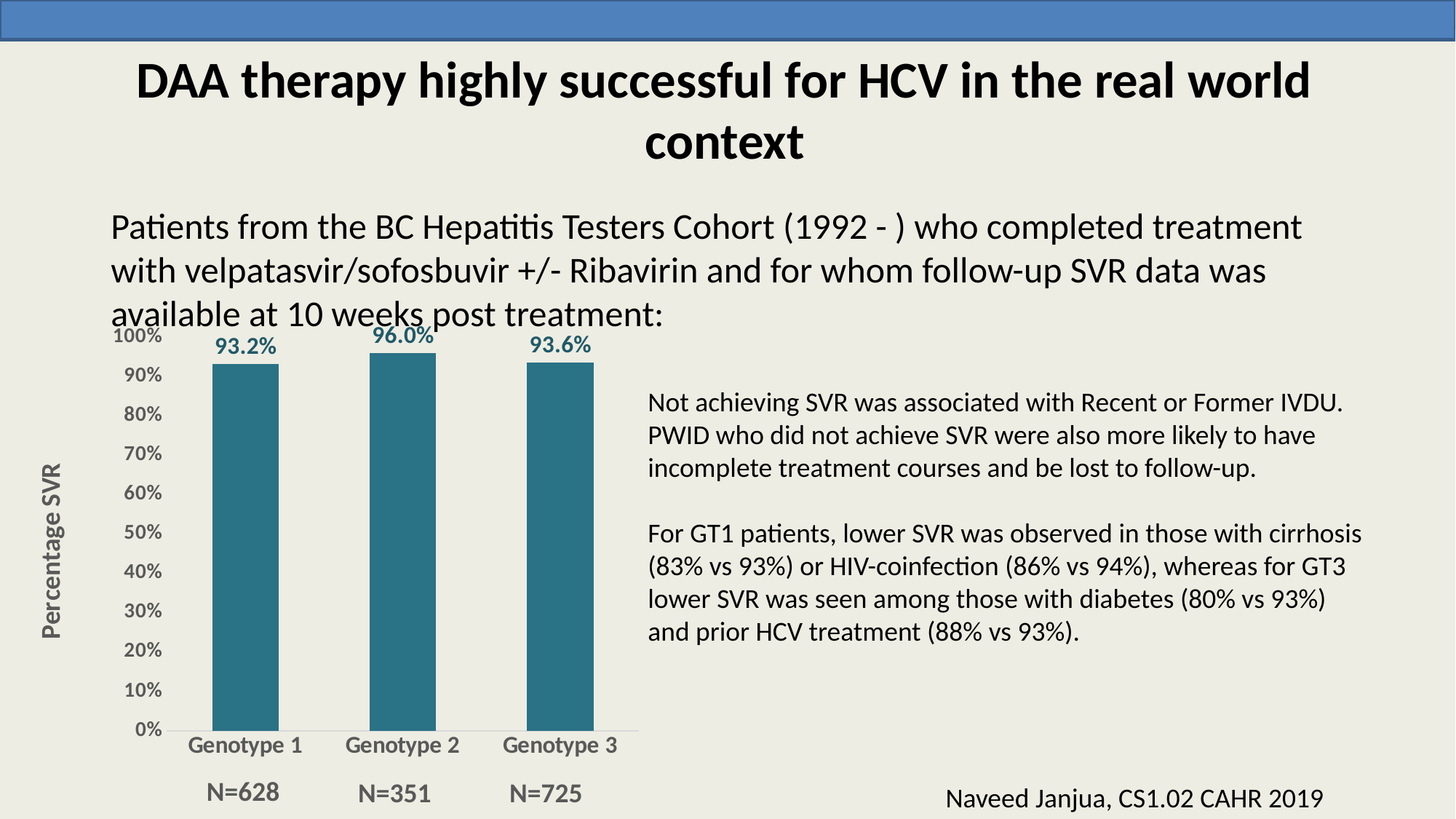
What is the percentage SVR for Genotype 1? 93.2% Which genotype has the highest percentage SVR? Genotype 2 What kind of chart is shown on the slide? Bar chart What is the difference in percentage SVR between Genotype 3 and Genotype 1? 0.4% What is the percentage SVR for Genotype 3? 93.6% Which genotype has the lowest percentage SVR? Genotype 1 Which has a higher percentage SVR, Genotype 2 or Genotype 3? Genotype 2 How many genotype categories are shown in the chart? 3 What is the difference in percentage SVR between Genotype 2 and Genotype 1? 2.8% What is the percentage SVR for Genotype 2? 96.0% Is the percentage SVR for Genotype 1 greater or less than 90%? greater What is the label of the vertical axis of the chart? Percentage SVR